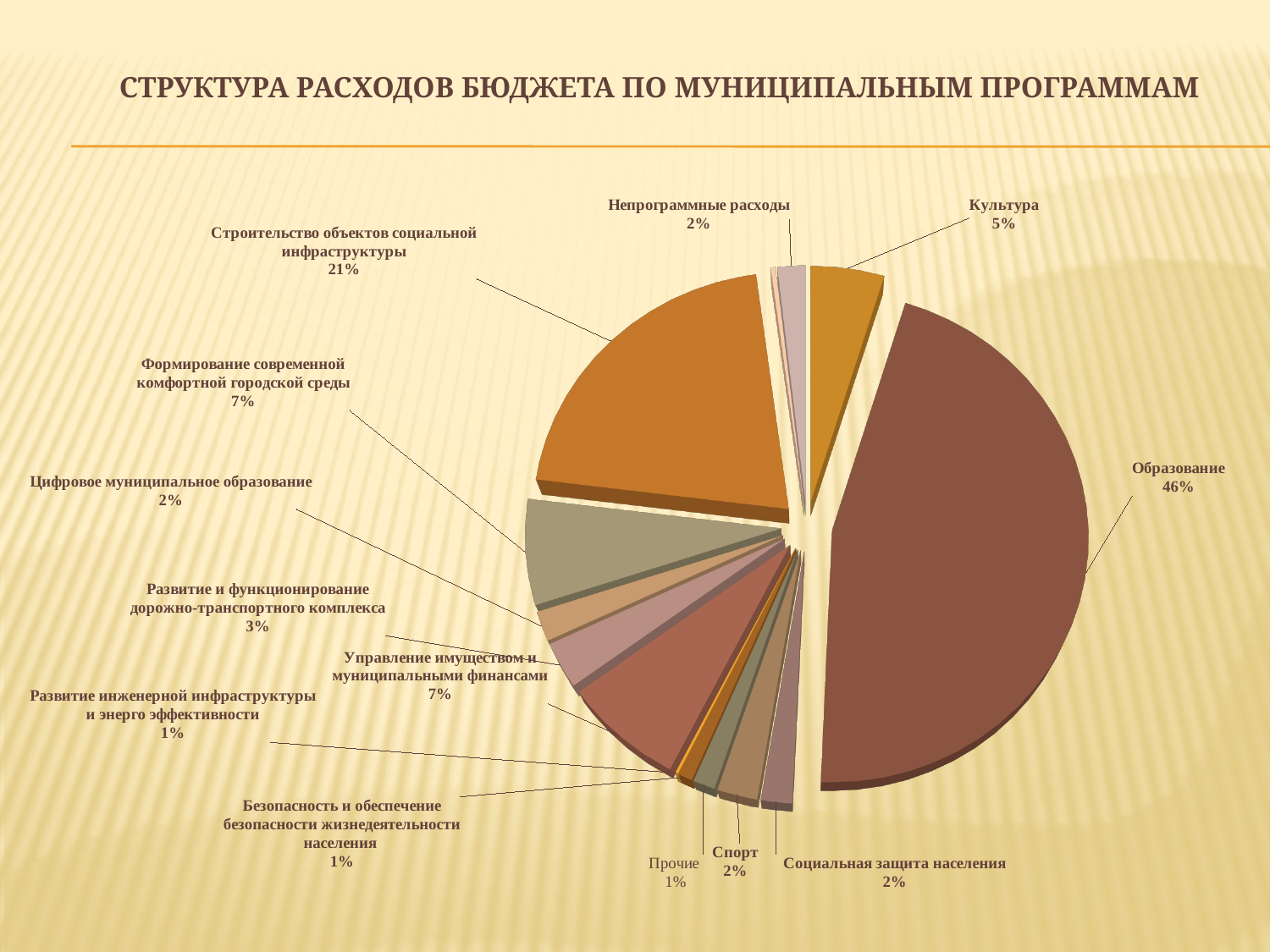
What is the combined share of Формирование современной комфортной городской среды and Цифровое муниципальное образование? 9% Which category has the largest share of the pie? Образование What percentage is shown for Развитие и функционирование дорожно-транспортного комплекса? 3% What percentage is shown for Культура? 5% What percentage is shown for Строительство объектов социальной инфраструктуры? 21% What percentage is shown for Управление имуществом и муниципальными финансами? 7% What type of chart is shown on the slide? pie chart How many categories (slices) does the pie chart have? 14 Which is larger: the share for Культура or the share for Спорт? Культура What is the difference in percentage points between Образование and Строительство объектов социальной инфраструктуры? 25 What is the title of the chart on the slide? СТРУКТУРА РАСХОДОВ БЮДЖЕТА ПО МУНИЦИПАЛЬНЫМ ПРОГРАММАМ What share of budget expenditure goes to Образование? 46%